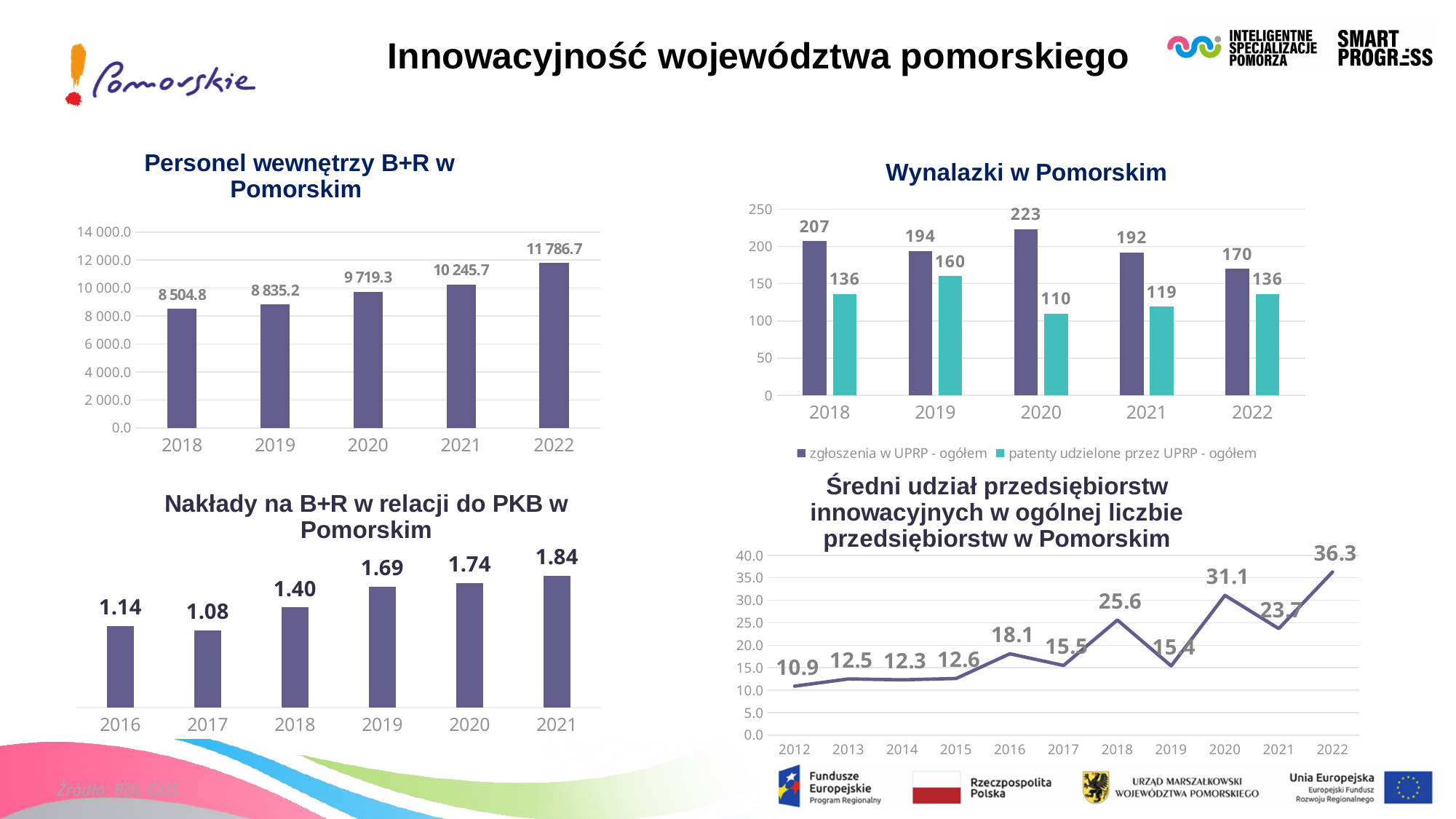
In the 'Średni udział przedsiębiorstw innowacyjnych w ogólnej liczbie przedsiębiorstw w Pomorskim' chart, what is the value for 2020? 31.1 In the 'Personel wewnętrzy B+R w Pomorskim' chart, do the values rise or fall from 2018 to 2022? rise In the 'Personel wewnętrzy B+R w Pomorskim' chart, which year has the lowest value? 2018 In the 'Nakłady na B+R w relacji do PKB w Pomorskim' chart, which is larger, the value for 2016 or 2017? 2016 In the 'Wynalazki w Pomorskim' chart, what is the difference between 'zgłoszenia w UPRP - ogółem' and 'patenty udzielone przez UPRP - ogółem' in 2022? 34 In the 'Nakłady na B+R w relacji do PKB w Pomorskim' chart, how many years are shown? 6 In the 'Nakłady na B+R w relacji do PKB w Pomorskim' chart, what is the value for 2019? 1.69 In the 'Personel wewnętrzy B+R w Pomorskim' chart, what is the value for 2022? 11 786.7 What kind of chart is 'Średni udział przedsiębiorstw innowacyjnych w ogólnej liczbie przedsiębiorstw w Pomorskim'? line chart In the 'Wynalazki w Pomorskim' chart, what is the value of 'zgłoszenia w UPRP - ogółem' for 2020? 223 In the 'Wynalazki w Pomorskim' chart, how many series does the legend list? 2 In the 'Wynalazki w Pomorskim' chart, which year has the highest value of 'patenty udzielone przez UPRP - ogółem'? 2019